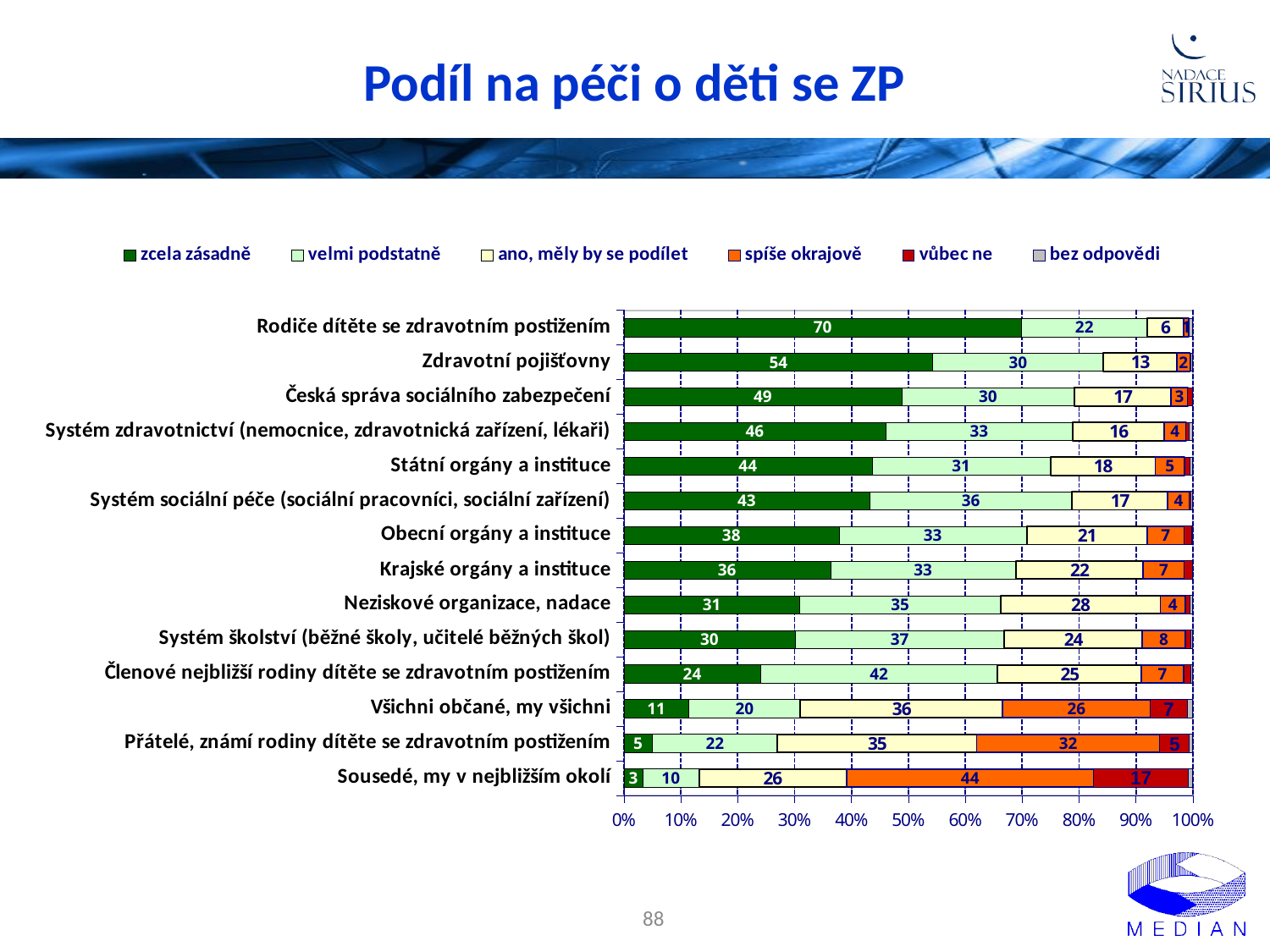
What is the title of the chart on the slide? Podíl na péči o děti se ZP Which category has the highest 'zcela zásadně' value? Rodiče dítěte se zdravotním postižením Which category has the lowest 'zcela zásadně' value? Sousedé, my v nejbližším okolí What is the difference between the 'zcela zásadně' values for 'Rodiče dítěte se zdravotním postižením' and 'Zdravotní pojišťovny'? 16 Which category has the highest 'spíše okrajově' value? Sousedé, my v nejbližším okolí How many series does the legend list? 6 How many categories are shown on the chart? 14 What kind of chart is shown on the slide? stacked bar chart What is the 'velmi podstatně' value for 'Členové nejbližší rodiny dítěte se zdravotním postižením'? 42 What is the 'zcela zásadně' value for 'Rodiče dítěte se zdravotním postižením'? 70 Which has a larger 'ano, měly by se podílet' value: 'Neziskové organizace, nadace' or 'Systém školství (běžné školy, učitelé běžných škol)'? Neziskové organizace, nadace What is the 'vůbec ne' value for 'Sousedé, my v nejbližším okolí'? 17